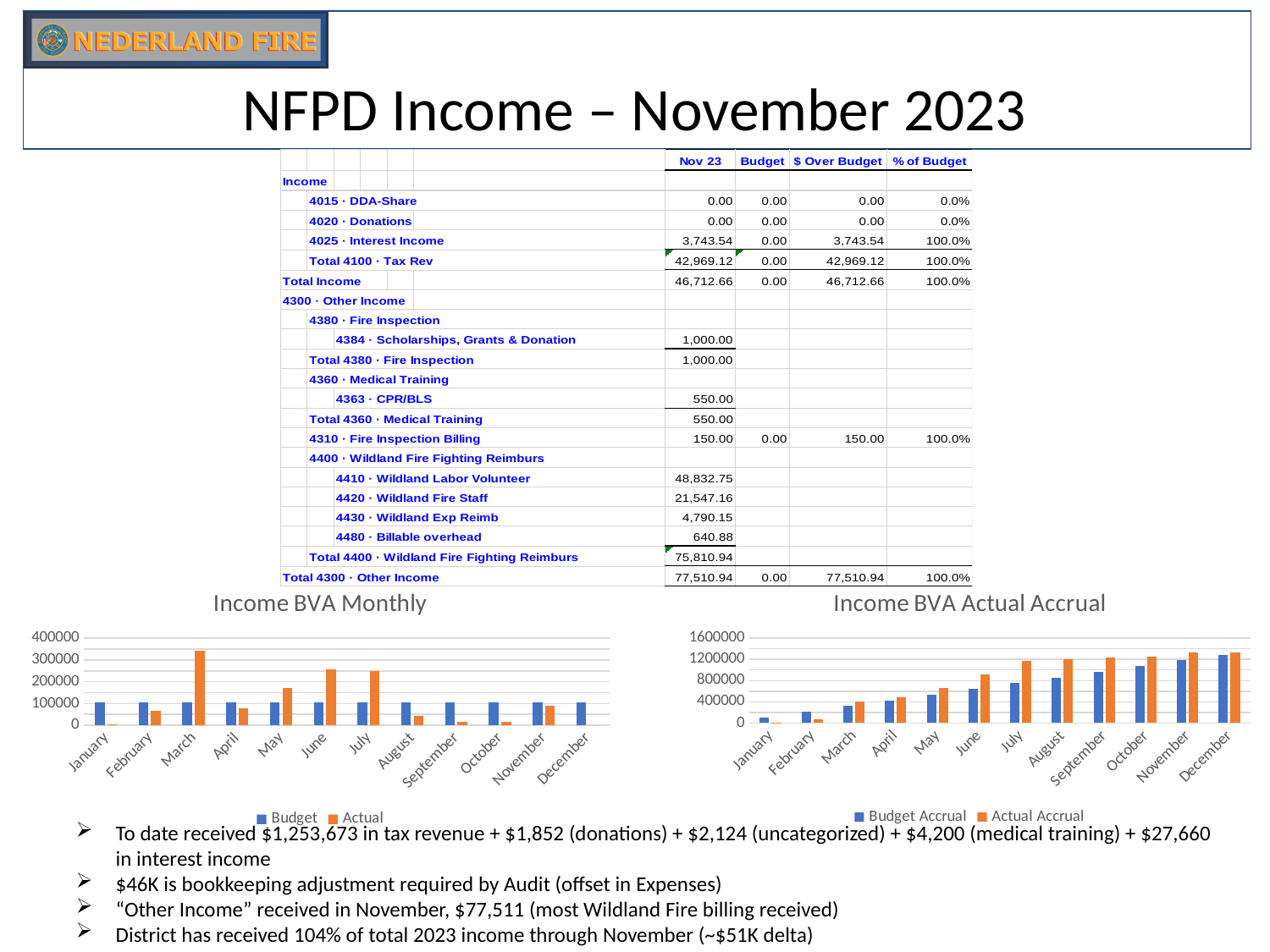
What kind of chart is the Income BVA Monthly chart? bar chart In the Income BVA Monthly chart, what are the two legend entries? Budget and Actual In the Income BVA Actual Accrual chart, do the Budget Accrual values rise or fall from January to December? rise In the Income BVA Actual Accrual chart, what are the two legend entries? Budget Accrual and Actual Accrual In the Income BVA Monthly chart, is the Actual value for March greater or less than 300000? greater In the Income BVA Actual Accrual chart, which is larger for July, Budget Accrual or Actual Accrual? Actual Accrual In the Income BVA Monthly chart, which is larger for March, Budget or Actual? Actual In the Income BVA Monthly chart, which month has the highest Actual value? March How many months are shown on the x axis of the Income BVA Monthly chart? 12 In the Income BVA Monthly chart, is the Actual value for August greater or less than 100000? less In the Income BVA Actual Accrual chart, is the Budget Accrual value for January greater or less than 400000? less In the Income BVA Monthly chart, how many series does the legend list? 2